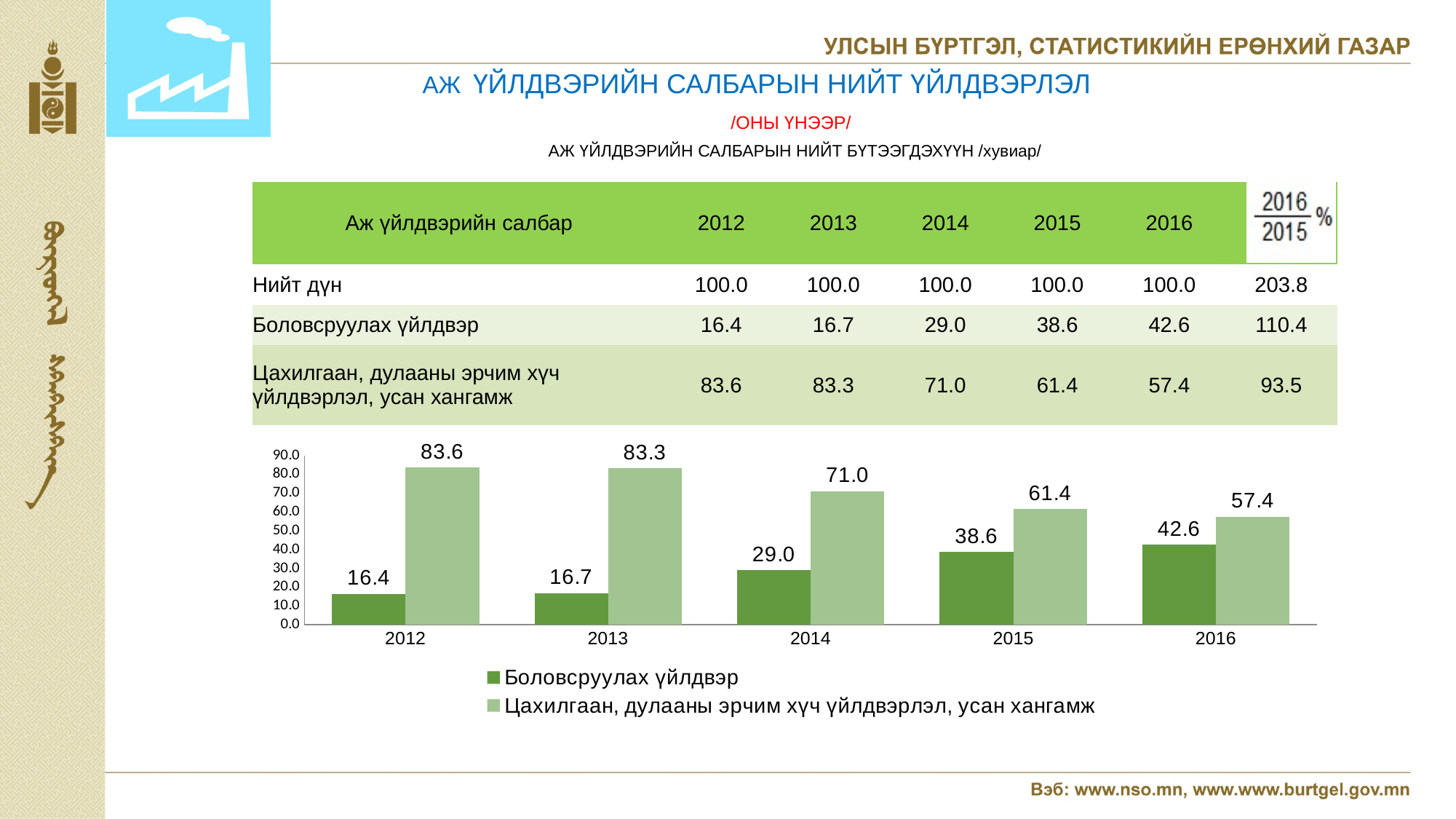
Do the values for Цахилгаан, дулааны эрчим хүч үйлдвэрлэл, усан хангамж rise or fall from 2012 to 2016? fall Which series has the larger value in 2013? Цахилгаан, дулааны эрчим хүч үйлдвэрлэл, усан хангамж How many series does the legend list? 2 How many years are shown on the x axis of the chart? 5 Is the value for Боловсруулах үйлдвэр in 2016 greater or less than 40.0? greater What is the value for Боловсруулах үйлдвэр in 2014? 29.0 In which year is the value for Цахилгаан, дулааны эрчим хүч үйлдвэрлэл, усан хангамж lowest? 2016 What is the value for Цахилгаан, дулааны эрчим хүч үйлдвэрлэл, усан хангамж in 2016? 57.4 What is the difference between the two series' values in 2015? 22.8 What is the difference between the Боловсруулах үйлдвэр values in 2016 and 2012? 26.2 What kind of chart is shown on the slide? bar chart In which year is the value for Боловсруулах үйлдвэр highest? 2016